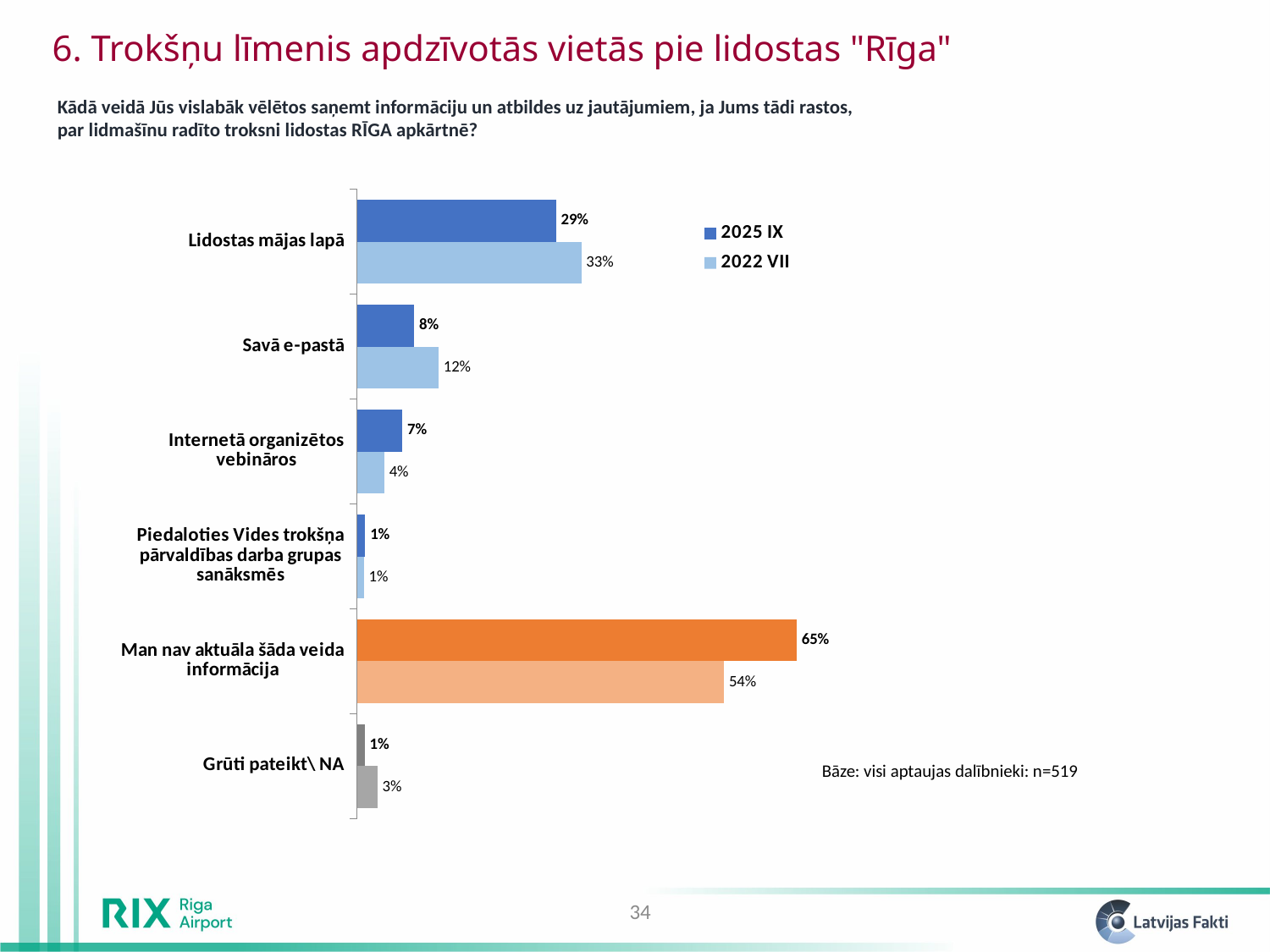
For "Internetā organizētos vebināros", which is larger: the 2025 IX value or the 2022 VII value? 2025 IX What is the 2022 VII value for "Savā e-pastā"? 12% What is the 2025 IX value for "Man nav aktuāla šāda veida informācija"? 65% How many categories are shown on the chart? 6 What is the 2025 IX value for "Lidostas mājas lapā"? 29% Which category has the highest 2025 IX value? Man nav aktuāla šāda veida informācija What is the difference between the 2022 VII and 2025 IX values for "Lidostas mājas lapā"? 4% What is the difference between the 2025 IX and 2022 VII values for "Man nav aktuāla šāda veida informācija"? 11% Which category has the lowest 2022 VII value? Piedaloties Vides trokšņa pārvaldības darba grupas sanāksmēs How many series does the legend list? 2 What is the 2022 VII value for "Grūti pateikt\ NA"? 3% What kind of chart is shown on the slide? Bar chart